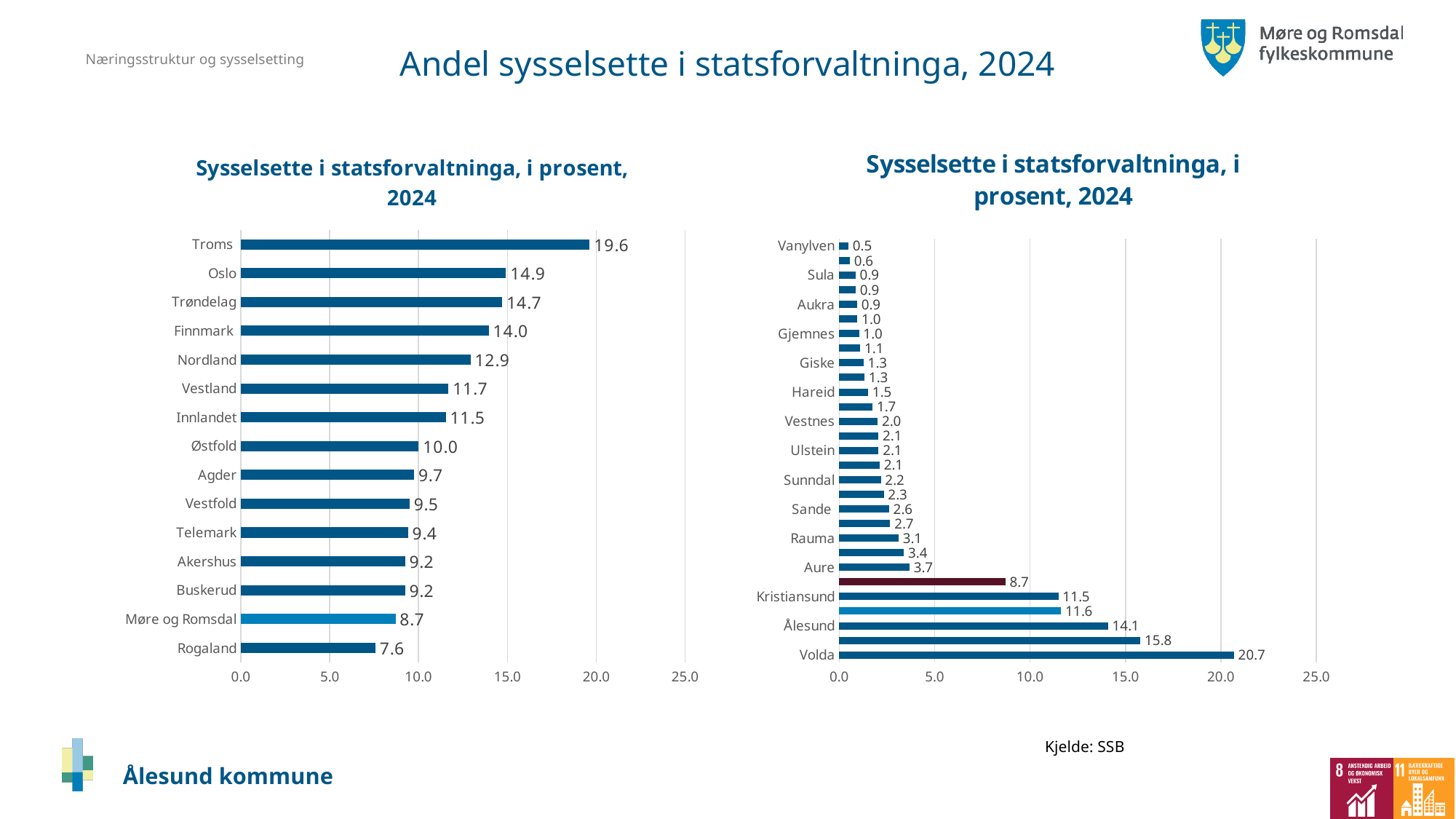
On the left chart, which category has the lowest value? Rogaland On the left chart, what is the difference between the values for Oslo and Trøndelag? 0.2 On the right chart, what is the difference between the values for Ålesund and Aure? 10.4 On the right chart, what is the value for Kristiansund? 11.5 On the left chart, what is the value for Troms? 19.6 On the right chart, what is the value for Volda? 20.7 On the right chart, which category has the highest value? Volda On the left chart, which bar is drawn in a lighter blue than the others? Møre og Romsdal On the left chart, which is larger, the value for Nordland or the value for Vestland? Nordland How many categories are shown on the left chart? 15 What kind of chart is the right chart? Bar chart On the left chart, what is the value for Møre og Romsdal? 8.7